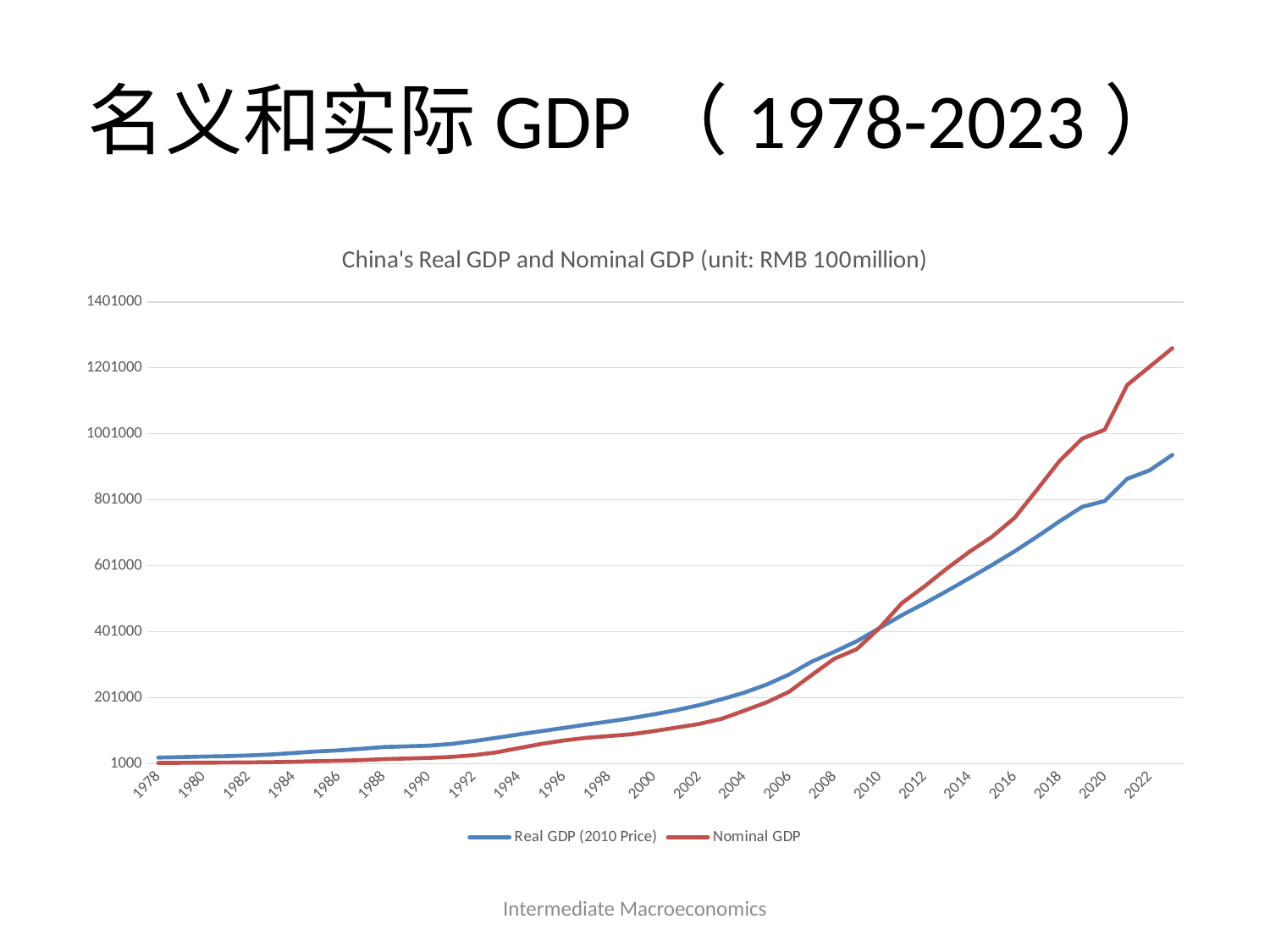
Around which year on the x axis do the Real GDP and Nominal GDP lines cross? 2010 Is the value of Real GDP (2010 Price) in 2022 greater or less than 1001000? less What is the title of the chart? China's Real GDP and Nominal GDP (unit: RMB 100million) What kind of chart is shown on the slide? Line chart Does Real GDP (2010 Price) rise or fall over the period shown? Rise Does Nominal GDP rise or fall from 1978 to the end of the period? Rise Is the value of Nominal GDP in 2022 greater or less than 1001000? greater How many series does the legend list? 2 In 2022, which series has the larger value, Real GDP (2010 Price) or Nominal GDP? Nominal GDP In 2000, which series has the larger value, Real GDP (2010 Price) or Nominal GDP? Real GDP (2010 Price) Is the value of Nominal GDP in 2000 greater or less than 201000? less Which series is drawn in red? Nominal GDP